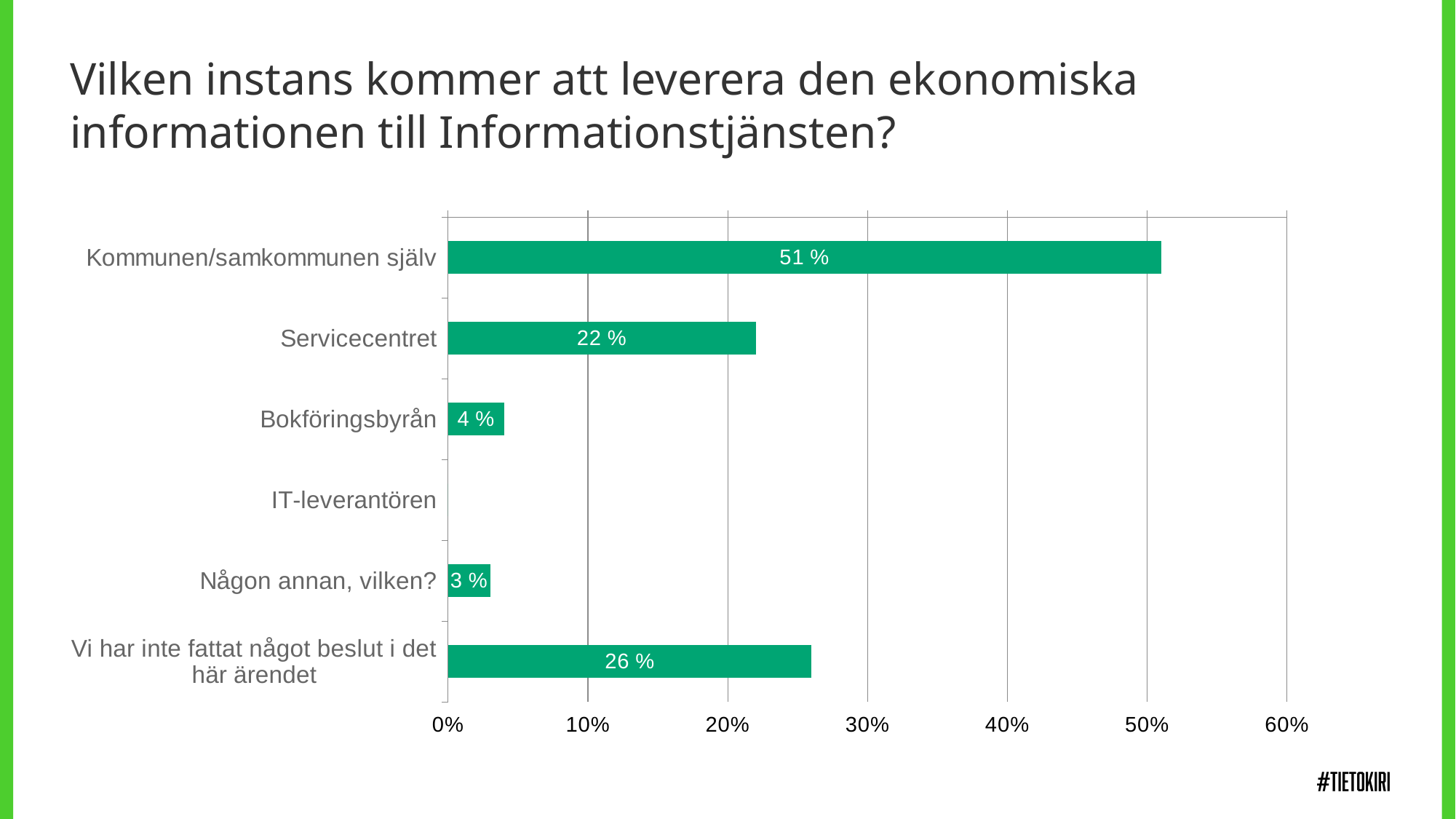
Is the value for Vi har inte fattat något beslut i det här ärendet greater or less than 30%? less Which category has the highest value? Kommunen/samkommunen själv What is the title of the slide? Vilken instans kommer att leverera den ekonomiska informationen till Informationstjänsten? How many categories are shown on the chart? 6 What is the value for Servicecentret? 22 % What is the value for Någon annan, vilken? 3 % What is the difference between the values for Kommunen/samkommunen själv and Servicecentret? 29 % What is the value for Bokföringsbyrån? 4 % What is the value for Vi har inte fattat något beslut i det här ärendet? 26 % What is the value for Kommunen/samkommunen själv? 51 % What kind of chart is shown on the slide? bar chart Which is larger: the value for Servicecentret or the value for Vi har inte fattat något beslut i det här ärendet? Vi har inte fattat något beslut i det här ärendet